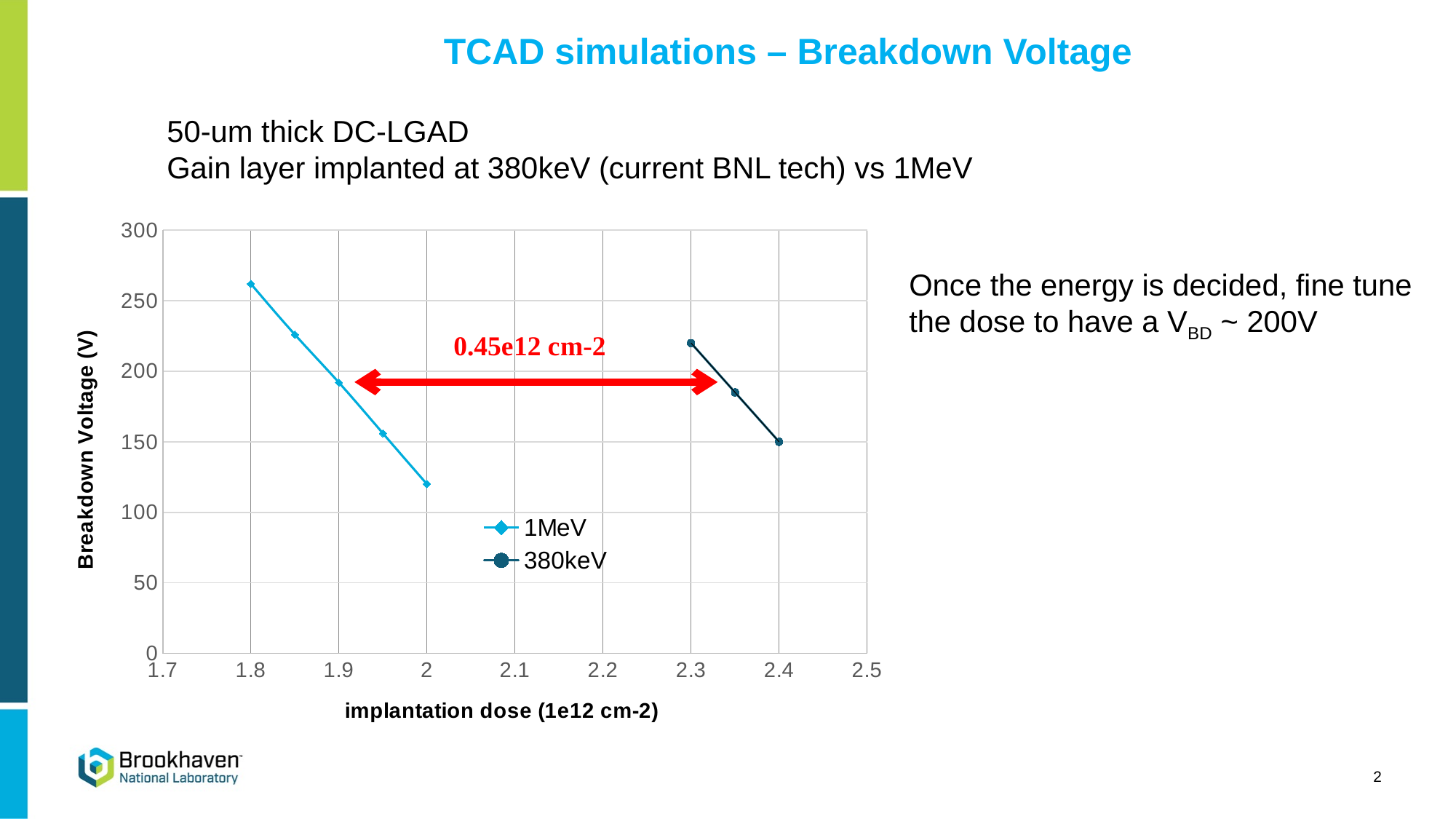
Is the breakdown voltage for the 1MeV series at a dose of 1.8 greater or less than 250? greater Is the breakdown voltage for the 380keV series at a dose of 2.3 greater or less than 200? greater Which series reaches the highest breakdown voltage on the chart? 1MeV How many series does the chart legend list? 2 How many data points are plotted for the 1MeV series? 5 How many data points are plotted for the 380keV series? 3 Does the breakdown voltage rise or fall as implantation dose increases for the 1MeV series? fall Which is larger: the breakdown voltage for 1MeV at a dose of 1.8 or for 380keV at a dose of 2.3? 1MeV at 1.8 Is the breakdown voltage for the 1MeV series at a dose of 2 greater or less than 150? less Does the breakdown voltage rise or fall as implantation dose increases for the 380keV series? fall What kind of chart is shown on the slide? line chart What is the title of the x axis of the chart? implantation dose (1e12 cm-2)